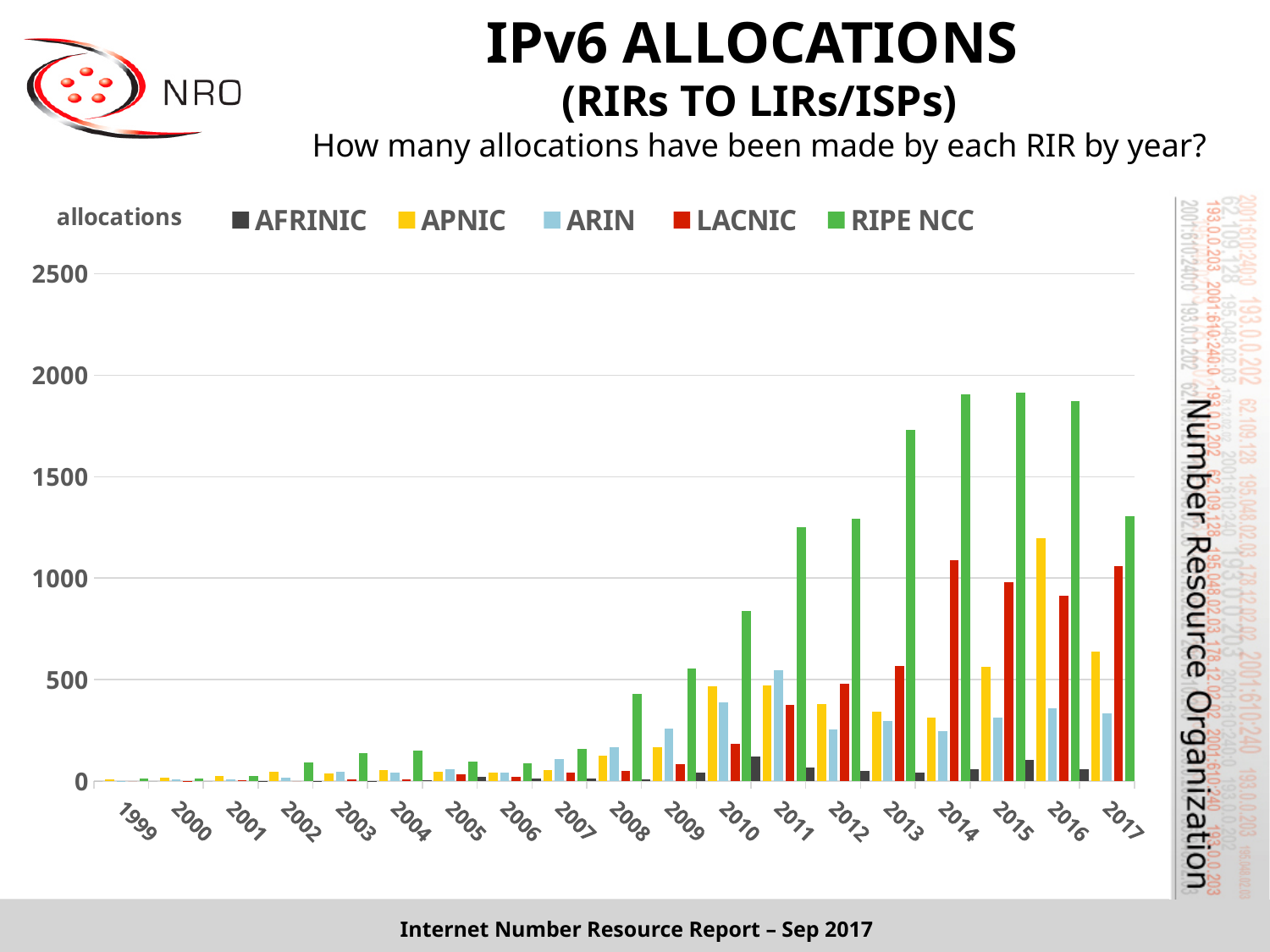
Is the value for RIPE NCC in 2014 greater or less than 1500? greater Which RIR has the lowest number of allocations in 2017? AFRINIC Is the value for APNIC in 2016 greater or less than 1000? greater Do the RIPE NCC values rise or fall from 2009 to 2015? rise How many series does the legend list? 5 What colour represents LACNIC in the legend? red In 2016, which is larger: the value for RIPE NCC or the value for LACNIC? RIPE NCC What kind of chart is shown on the slide? bar chart How many years are shown along the x axis? 19 Is the value for AFRINIC in 2016 greater or less than 500? less Which RIR has the highest number of allocations in 2015? RIPE NCC